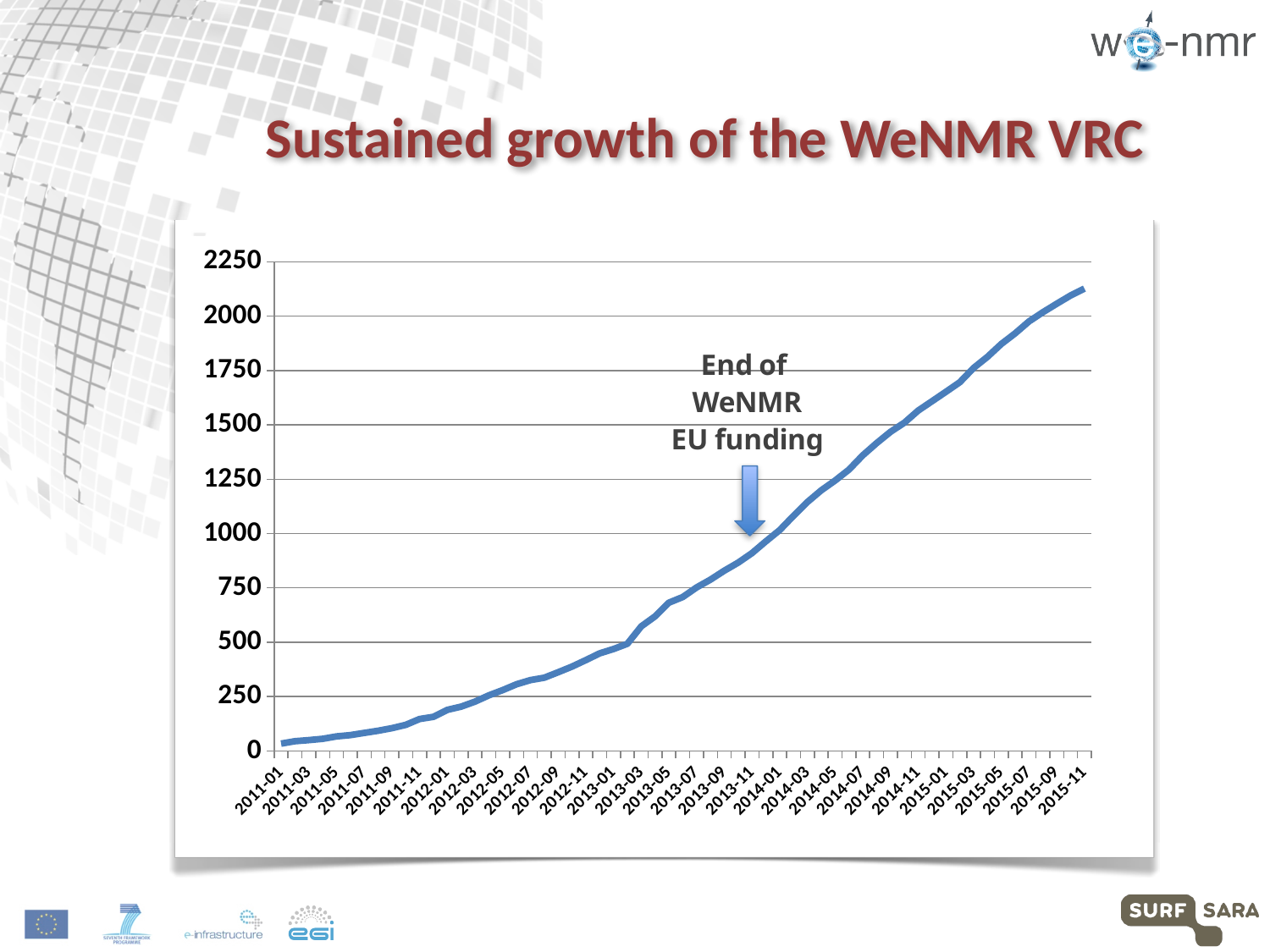
Is the value for 2012-07 greater or less than 250? greater What event does the annotation with the arrow on the chart mark? End of WeNMR EU funding Do the values rise or fall along the x axis from 2011-01 to 2015-11? rise Which has the larger value, 2012-01 or 2015-01? 2015-01 What is the title of the chart on the slide? Sustained growth of the WeNMR VRC Is the value for 2011-01 greater or less than 250? less Is the value for 2015-11 greater or less than 2000? greater Which x-axis label has the highest value on the line? 2015-11 Which x-axis label has the lowest value on the line? 2011-01 What kind of chart is shown on the slide? line chart